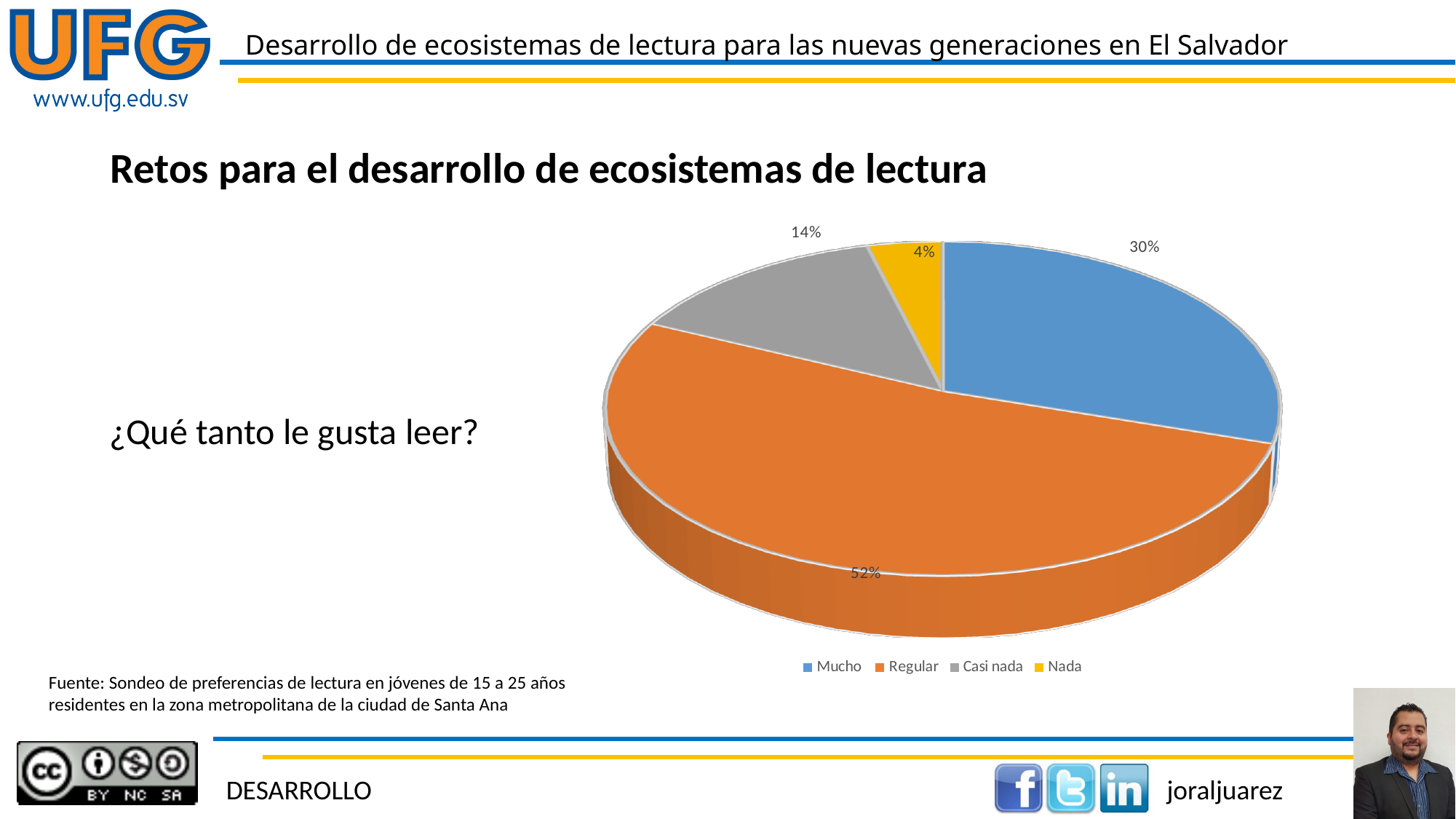
What percentage of the pie is the Regular slice? 52% What kind of chart is shown on the slide? pie chart How many categories does the legend list? 4 Which slice is larger, Casi nada or Nada? Casi nada What percentage of the pie is the Nada slice? 4% Which category has the smallest slice of the pie? Nada Which category has the largest slice of the pie? Regular What percentage of the pie is the Casi nada slice? 14% What colour is the Regular slice? orange What question does the chart answer, according to the text on the slide? ¿Qué tanto le gusta leer? What percentage of the pie is the Mucho slice? 30% What is the difference in percentage points between the Regular and Mucho slices? 22